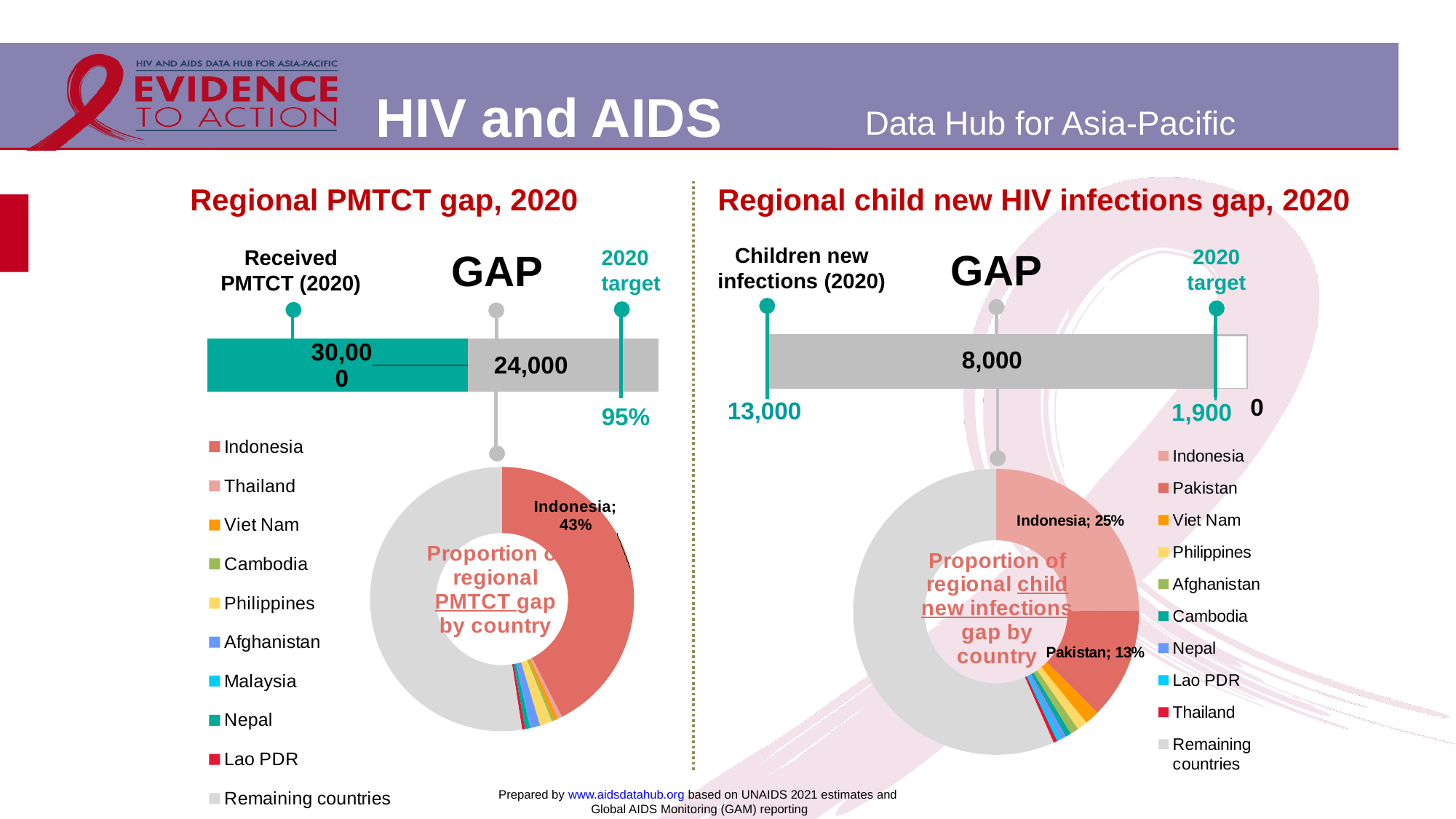
What kind of chart is used to show the proportion of the regional child new infections gap by country? Donut (pie) chart In the Regional PMTCT gap, 2020 donut chart, what share of the regional PMTCT gap is attributed to Indonesia? 43% How many entries does the legend of the Regional PMTCT gap, 2020 donut chart list? 10 In the Regional PMTCT gap, 2020 chart, how many people received PMTCT in 2020? 30,000 In the Regional PMTCT gap, 2020 chart, what is the size of the GAP shown on the bar? 24,000 In the Regional PMTCT gap, 2020 chart, what is the 2020 target? 95% In the Regional child new HIV infections gap, 2020 chart, what is the size of the GAP shown on the bar? 8,000 In the Regional child new HIV infections gap, 2020 donut chart, what is the difference in percentage points between Indonesia's share and Pakistan's share? 12% In the Regional child new HIV infections gap, 2020 chart, what is the 2020 target value? 1,900 In the Regional child new HIV infections gap, 2020 donut chart, what share of the gap is attributed to Pakistan? 13% In the Regional child new HIV infections gap, 2020 chart, how many children new infections were there in 2020? 13,000 In the Regional child new HIV infections gap, 2020 donut chart, which has the larger share, Indonesia or Pakistan? Indonesia